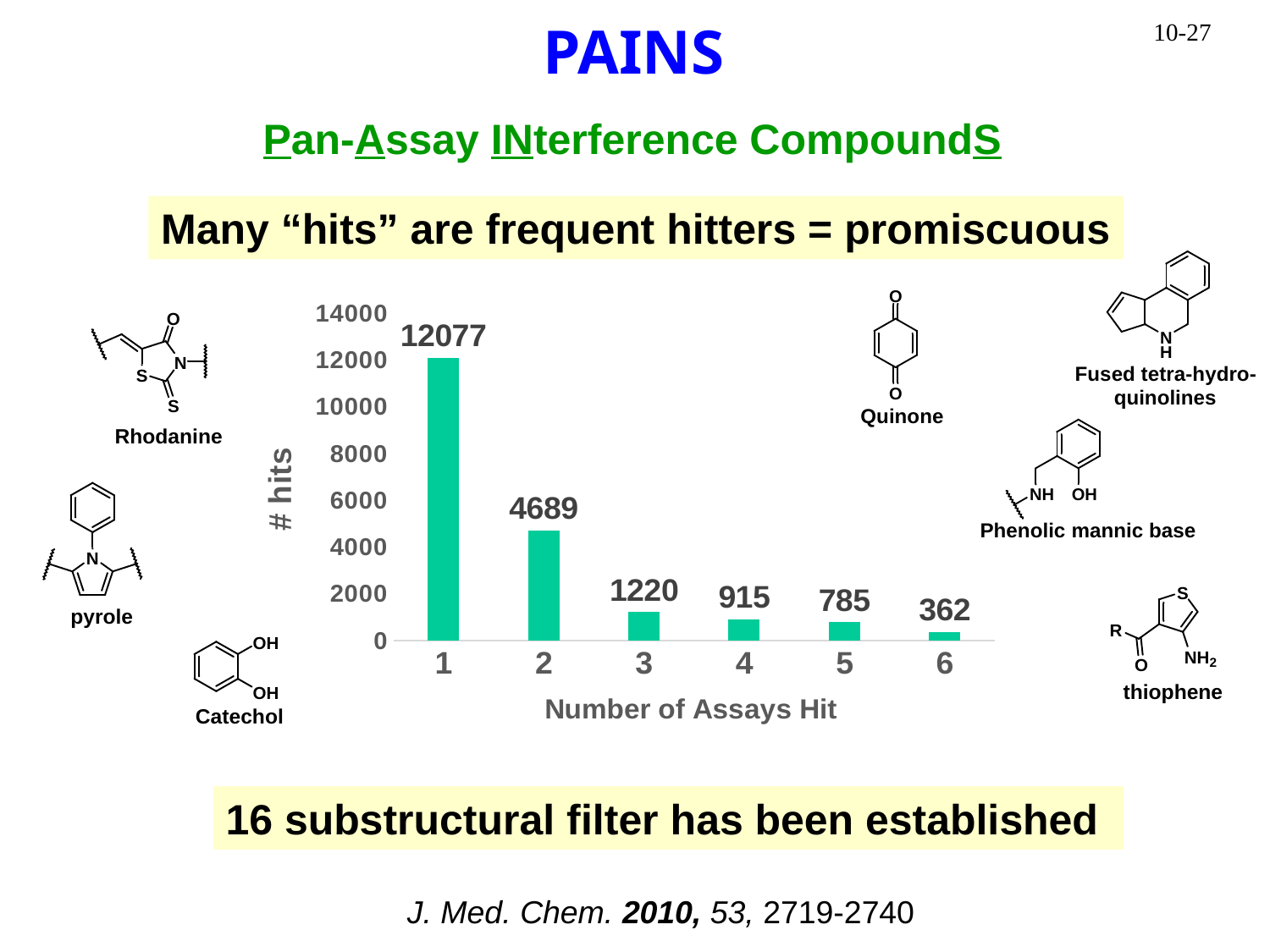
What is the number of hits for compounds hitting 6 assays? 362 How many categories are shown on the x axis of the chart? 6 Which has more hits: 2 assays hit or 3 assays hit? 2 assays hit Which number of assays hit has the lowest number of hits? 6 Which number of assays hit has the highest number of hits? 1 What is the difference in hits between 4 assays hit and 5 assays hit? 130 What is the number of hits for compounds hitting 1 assay? 12077 Is the value for 2 assays hit greater or less than 4000? greater What is the number of hits for compounds hitting 3 assays? 1220 Do the values rise or fall as the number of assays hit increases? fall What is the difference in hits between 1 assay hit and 2 assays hit? 7388 What kind of chart is shown on the slide? bar chart